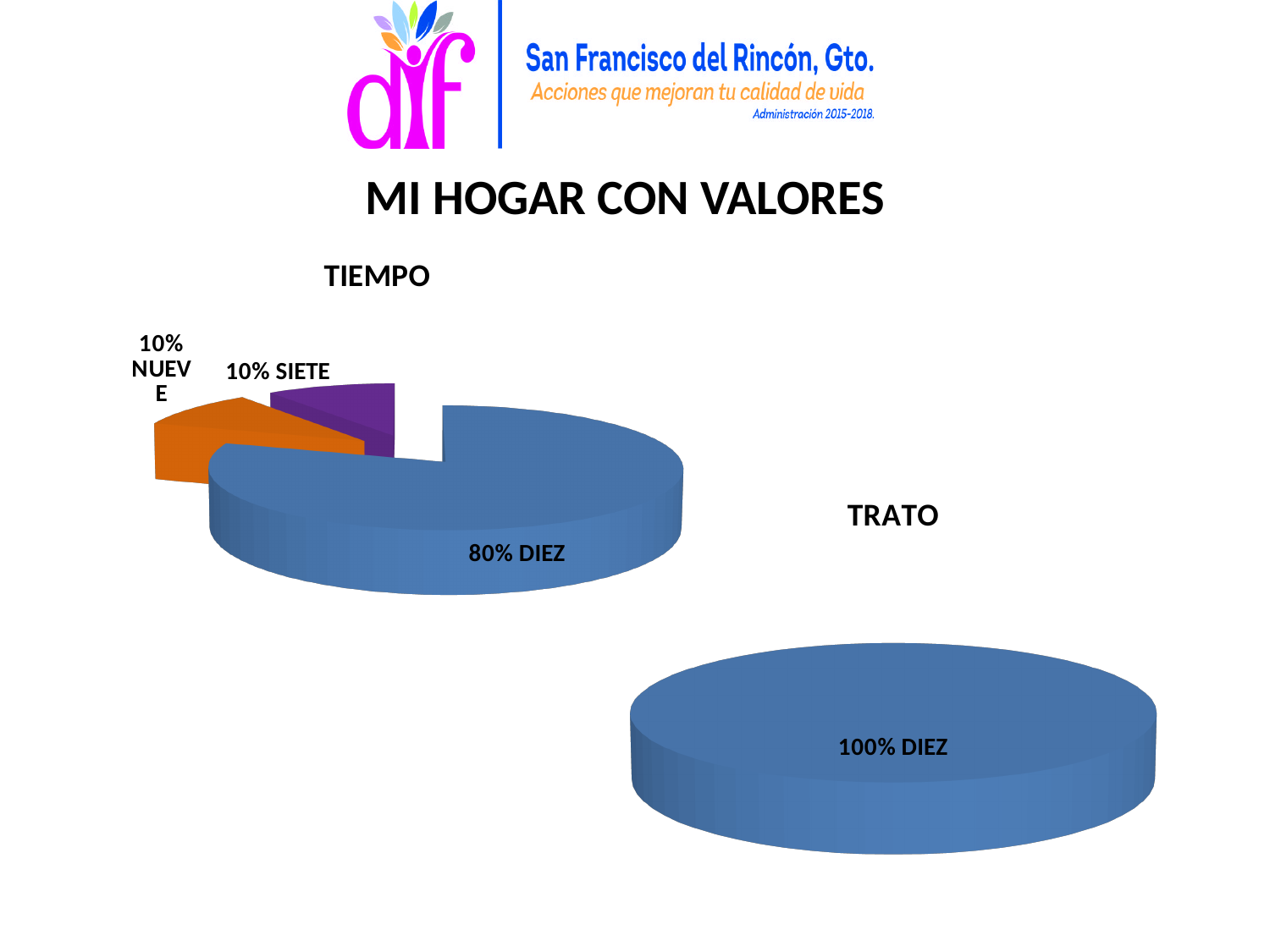
In the TIEMPO chart, what colour is the DIEZ slice? Blue What kind of chart is the TIEMPO chart? Pie chart In the TIEMPO chart, which category has the largest slice? DIEZ In the TIEMPO chart, what share does DIEZ have? 80% In the TIEMPO chart, what is the difference between the DIEZ share and the SIETE share? 70% In the TIEMPO chart, how many slices does the pie have? 3 In the TRATO chart, how many slices does the pie have? 1 In the TIEMPO chart, what share does NUEVE have? 10% In the TIEMPO chart, which is larger, the DIEZ slice or the NUEVE slice? DIEZ What kind of chart is the TRATO chart? Pie chart In the TIEMPO chart, what share does SIETE have? 10% In the TRATO chart, what share does DIEZ have? 100%